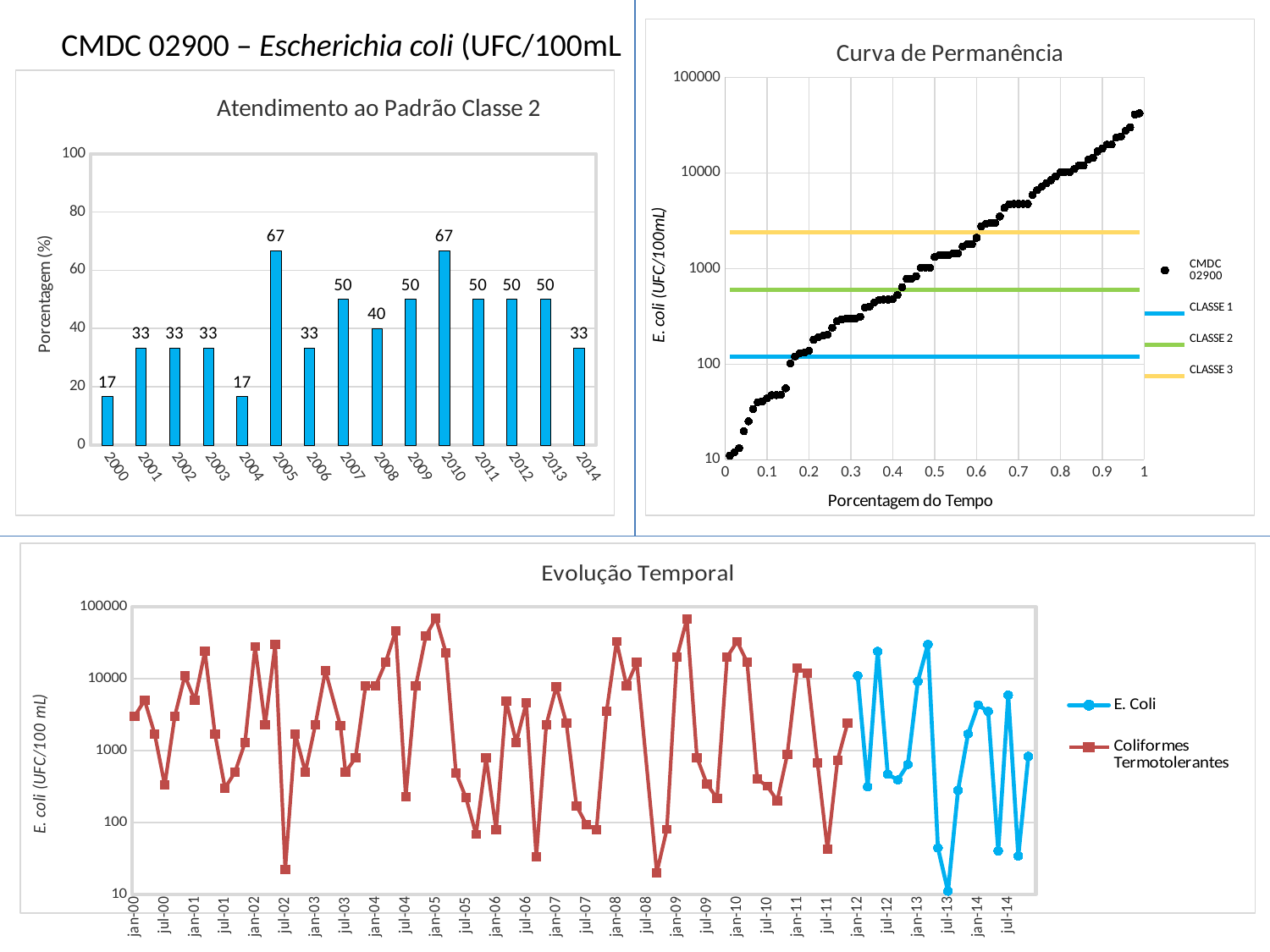
How many entries does the legend of the 'Curva de Permanência' chart list? 4 What kind of chart is 'Atendimento ao Padrão Classe 2'? Bar chart What is the x-axis title of the 'Curva de Permanência' chart? Porcentagem do Tempo In the 'Atendimento ao Padrão Classe 2' chart, which year has the larger value, 2006 or 2008? 2008 In the 'Atendimento ao Padrão Classe 2' chart, what is the value for 2008? 40 How many series does the legend of the 'Evolução Temporal' chart list? 2 In the 'Curva de Permanência' chart, is the CLASSE 3 line greater or less than 1000? Greater How many years are shown on the x axis of the 'Atendimento ao Padrão Classe 2' chart? 15 In the 'Atendimento ao Padrão Classe 2' chart, what is the difference between the values for 2005 and 2004? 50 In the 'Evolução Temporal' chart, which series is drawn in blue? E. Coli In the 'Atendimento ao Padrão Classe 2' chart, what is the value for 2005? 67 In the 'Curva de Permanência' chart, do the CMDC 02900 values rise or fall as Porcentagem do Tempo increases? Rise